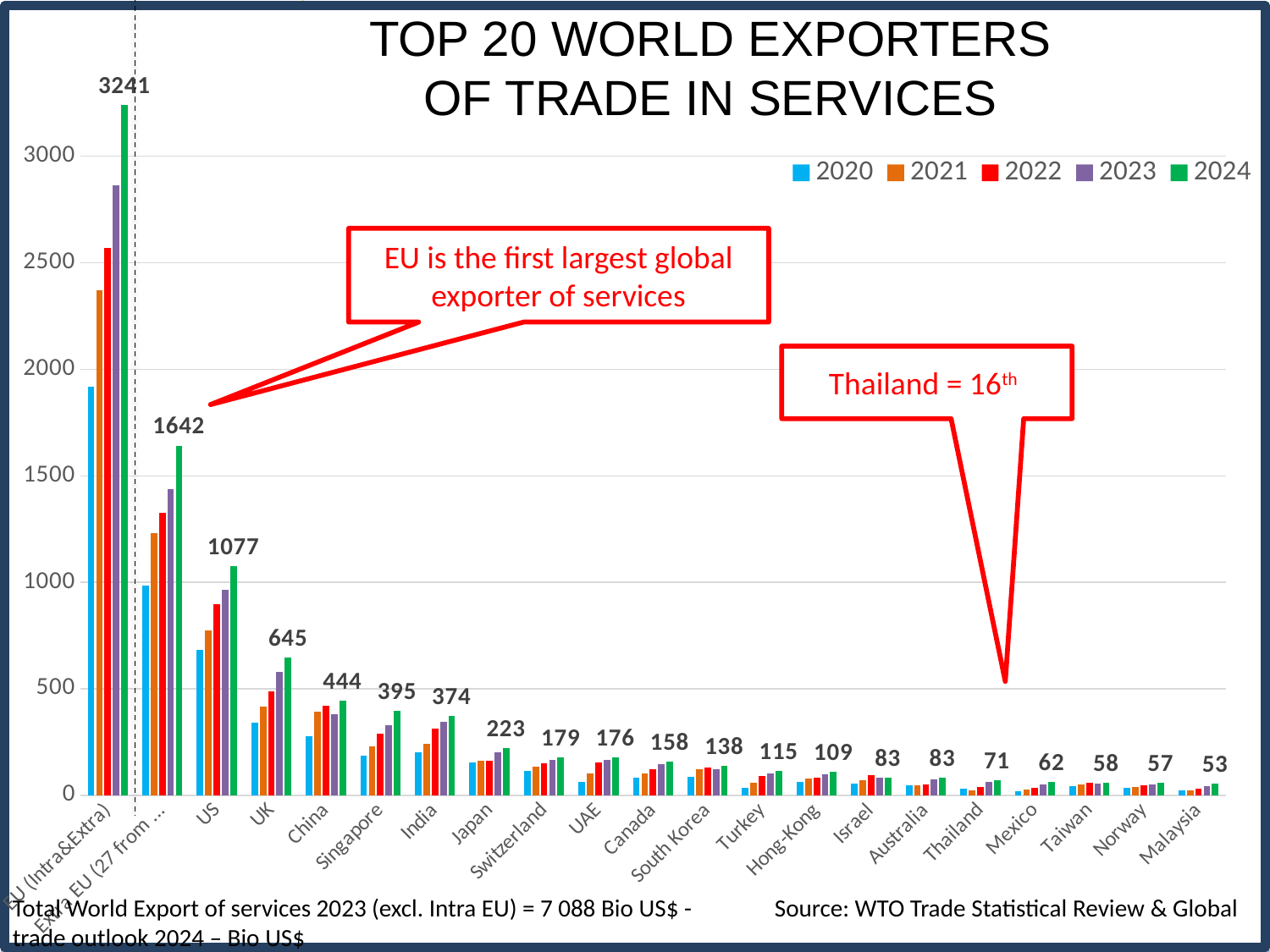
What kind of chart is shown on the slide? bar chart Which category has the lowest 2024 value? Malaysia What is the 2024 value for the US? 1077 Is the 2020 value for EU (Intra&Extra) greater or less than 1500? greater Which has the larger 2024 value, Singapore or India? Singapore What is the 2024 value for Thailand? 71 Do the values for the US rise or fall from 2020 to 2024? rise How many series does the legend list? 5 Is the 2020 value for China greater or less than 500? less What is the 2024 value for Japan? 223 Which category has the highest 2024 value? EU (Intra&Extra) What is the difference between the 2024 values for the US and the UK? 432